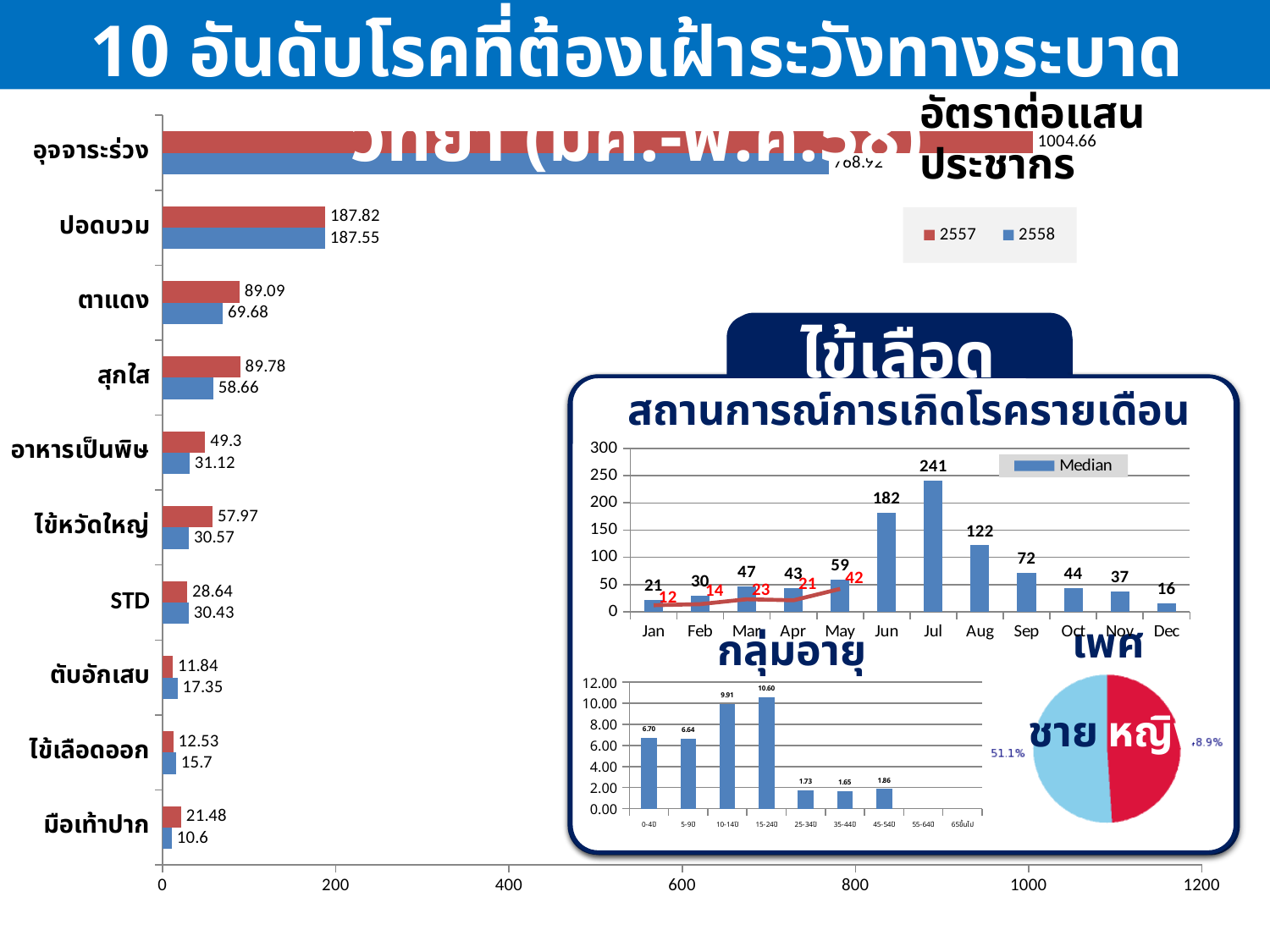
In the main bar chart of the 10 diseases, what is the difference between the 2557 and 2558 values for สุกใส? 31.12 In the main bar chart of the 10 diseases, what is the value for ปอดบวม in 2557? 187.82 In the main bar chart of the 10 diseases, which disease has the highest value in 2557? อุจจาระร่วง In the main bar chart of the 10 diseases, what is the value for ไข้หวัดใหญ่ in 2558? 30.57 In the main bar chart of the 10 diseases, how many diseases are shown? 10 In the monthly chart titled สถานการณ์การเกิดโรครายเดือน, what is the value for Jul? 241 In the age group chart titled กลุ่มอายุ, which age group has the highest value? 15-24 In the main bar chart of the 10 diseases, which is larger for STD: the 2557 value or the 2558 value? 2558 What type of chart is the chart titled เพศ? pie chart In the monthly chart titled สถานการณ์การเกิดโรครายเดือน, what is the difference between the Jun and Aug values? 60 In the main bar chart of the 10 diseases, how many series does the legend list? 2